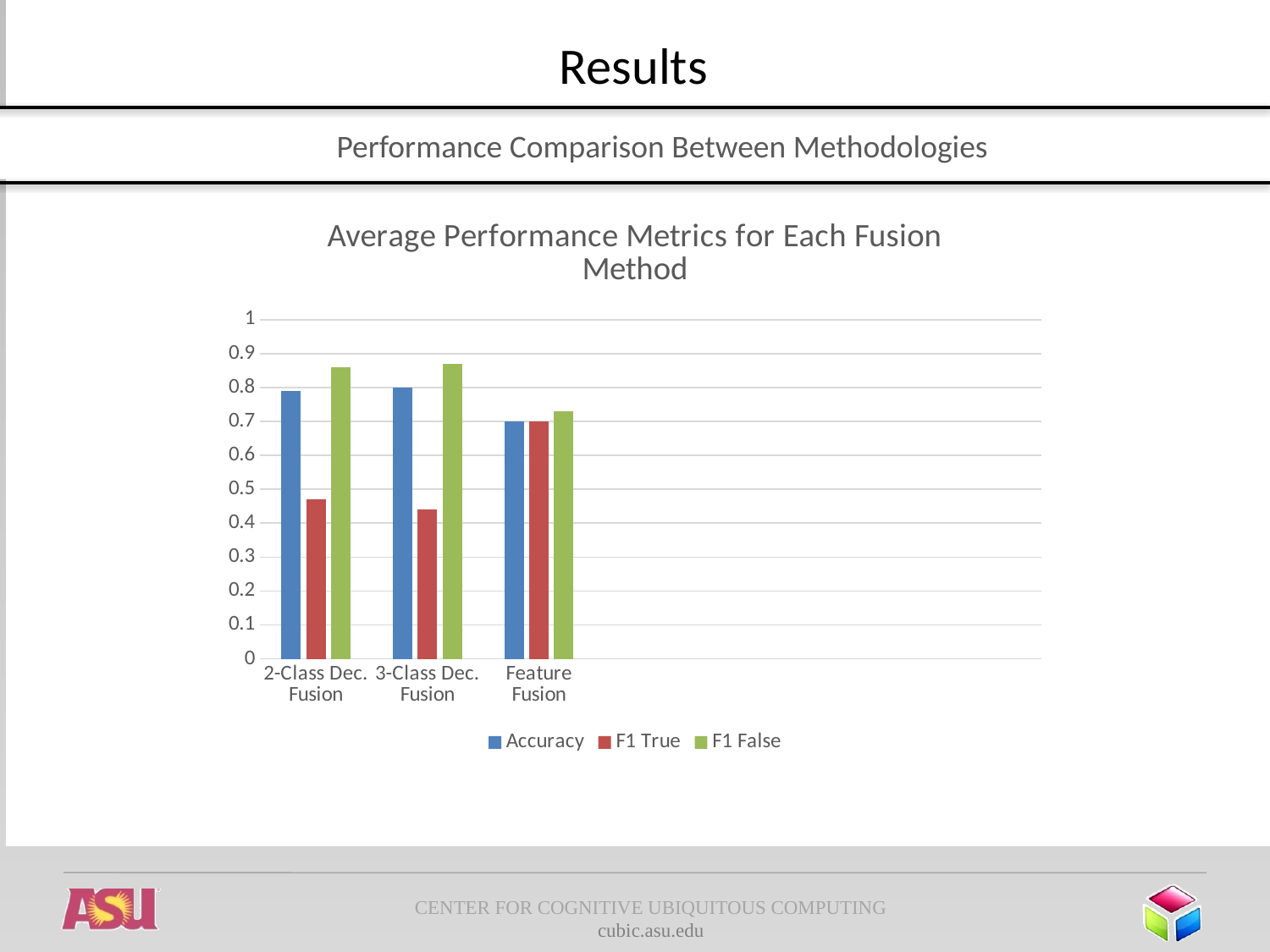
For 2-Class Dec. Fusion, which is larger: Accuracy or F1 True? Accuracy What is the title of the chart? Average Performance Metrics for Each Fusion Method How many series does the legend list? 3 How many fusion methods are shown on the x axis? 3 Is the F1 True value for 3-Class Dec. Fusion greater or less than 0.5? less Is the Accuracy value for 2-Class Dec. Fusion greater or less than 0.7? greater Is the F1 False value for 3-Class Dec. Fusion greater or less than 0.8? greater Which series is shown in green in the legend? F1 False Which fusion method has the lowest F1 False value? Feature Fusion What kind of chart is shown on the slide? bar chart Which fusion method has the highest F1 True value? Feature Fusion